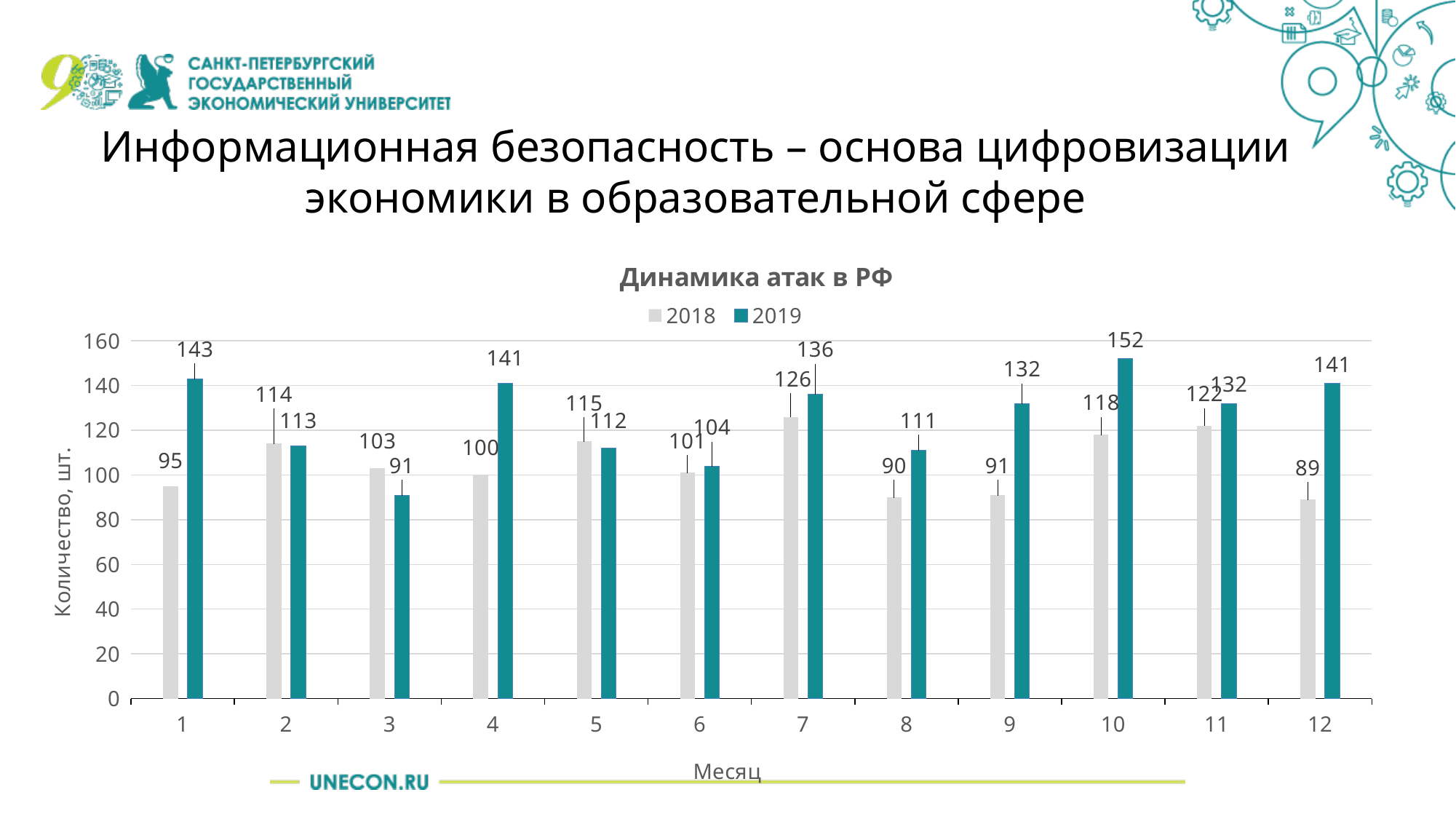
What is the value for 2018 in month 7? 126 Which month has the highest value for the 2019 series? 10 Which month has the lowest value for the 2018 series? 12 What is the difference between the 2019 and 2018 values in month 10? 34 What is the value for 2019 in month 1? 143 What kind of chart is shown on the slide? bar chart How many months are shown on the x axis? 12 What is the title of the chart? Динамика атак в РФ Which month has the lowest value for the 2019 series? 3 In month 3, which series has the larger value, 2018 or 2019? 2018 What is the value for 2018 in month 12? 89 How many series does the legend list? 2